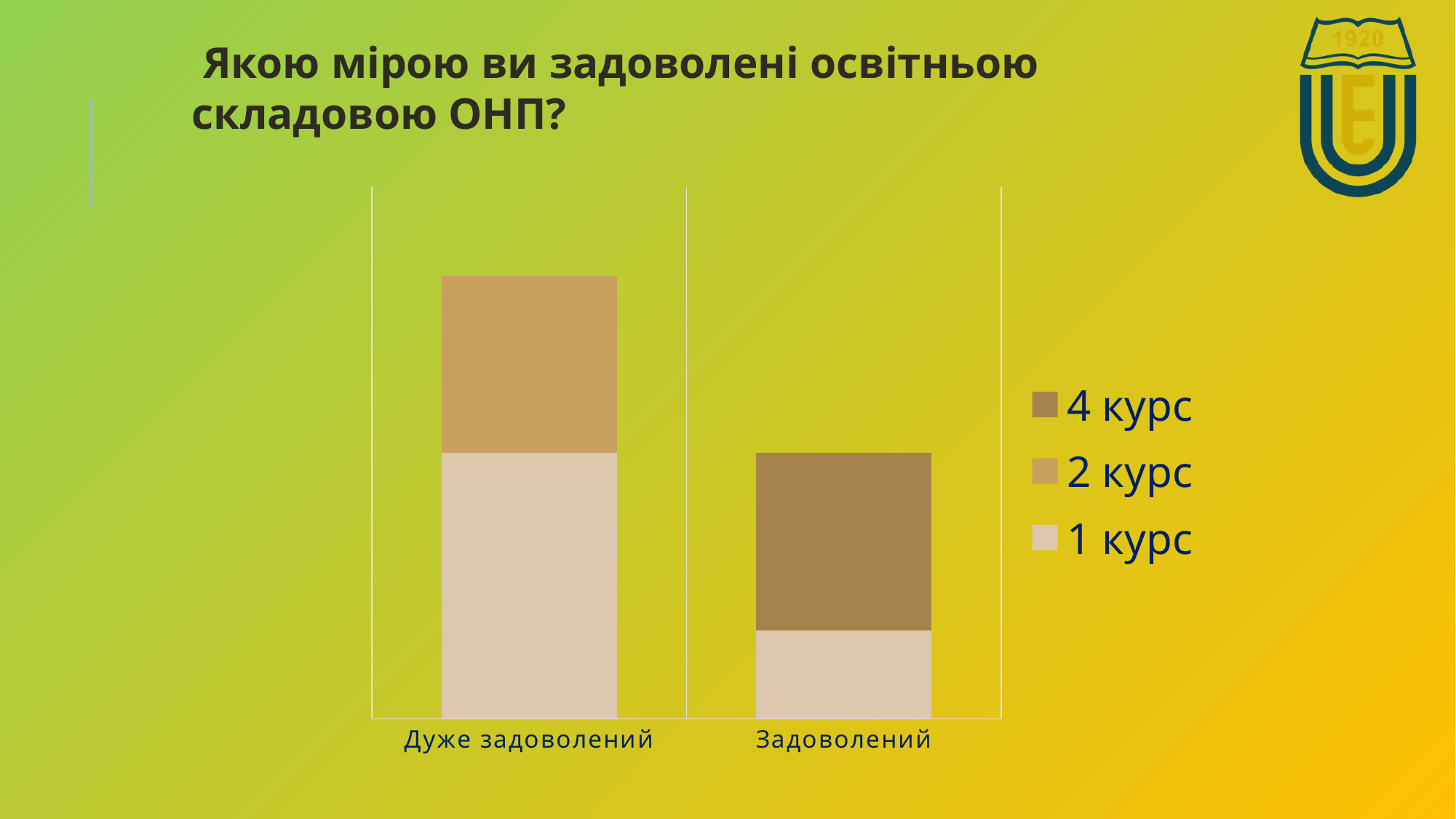
Which category has the taller stacked bar overall? Дуже задоволений Which series appears in the "Задоволений" bar but not in the "Дуже задоволений" bar? 4 курс How many categories are shown on the x axis of the chart? 2 What are the names of the two categories on the x axis? Дуже задоволений, Задоволений What kind of chart is shown on the slide? Stacked bar chart Which series appears in the "Дуже задоволений" bar but not in the "Задоволений" bar? 2 курс Is the total bar for "Дуже задоволений" larger or smaller than the total bar for "Задоволений"? Larger Within the "Задоволений" bar, which series has the larger segment: 1 курс or 4 курс? 4 курс Which category has the shorter stacked bar overall? Задоволений Within the "Дуже задоволений" bar, which series has the larger segment: 1 курс or 2 курс? 1 курс How many series does the chart legend list? 3 Which series is listed first (at the top) in the chart legend? 4 курс